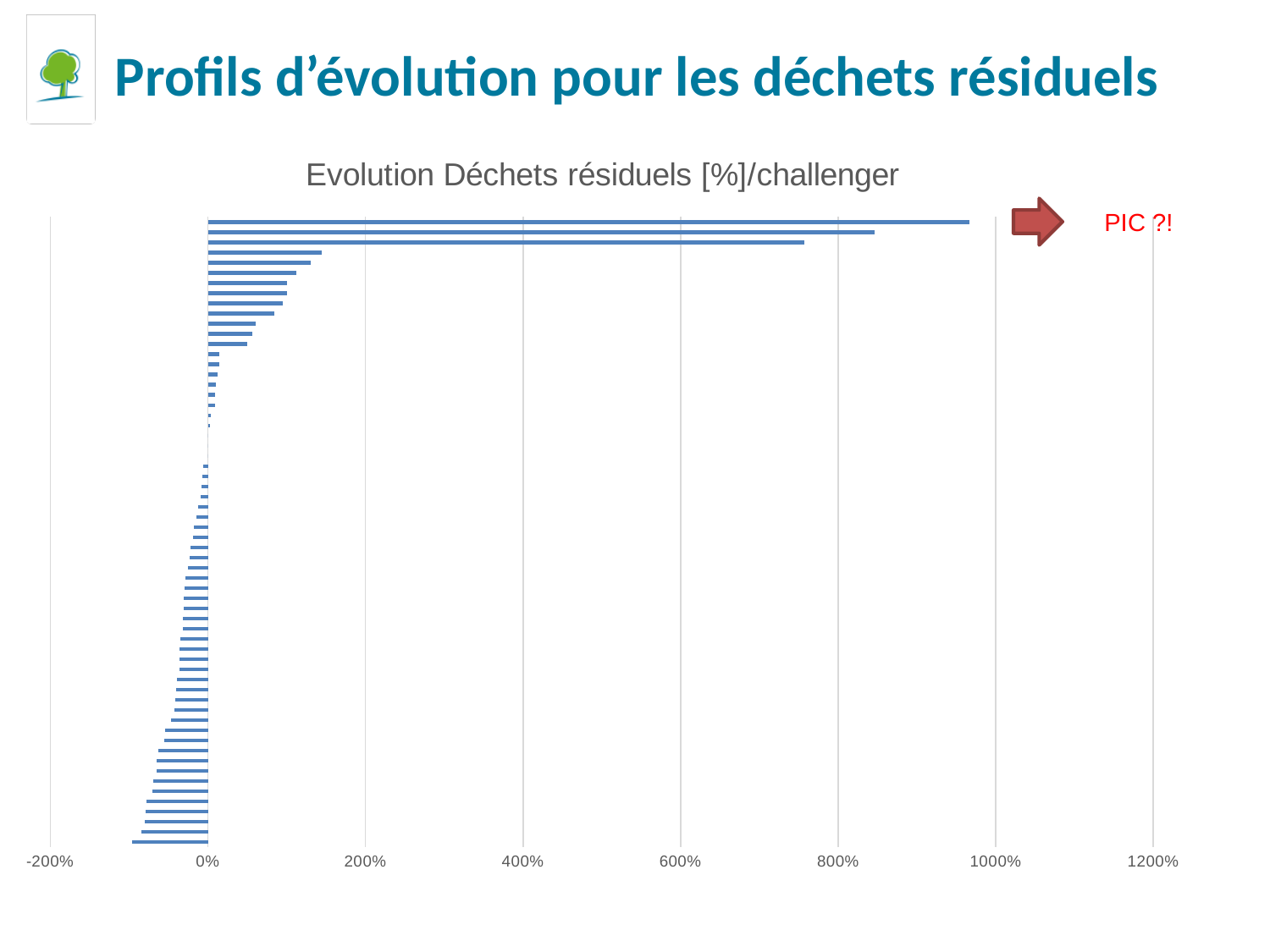
Do the bar values increase or decrease going from the top of the chart to the bottom? decrease What is the highest value shown on the x axis? 1200% Is the value of the bottom bar greater or less than -200%? greater Is the value of the longest bar (top bar) greater or less than 800%? greater What kind of chart is shown on the slide? bar chart Is the value of the longest bar greater or less than 1000%? less What is the title of the chart? Evolution Déchets résiduels [%]/challenger